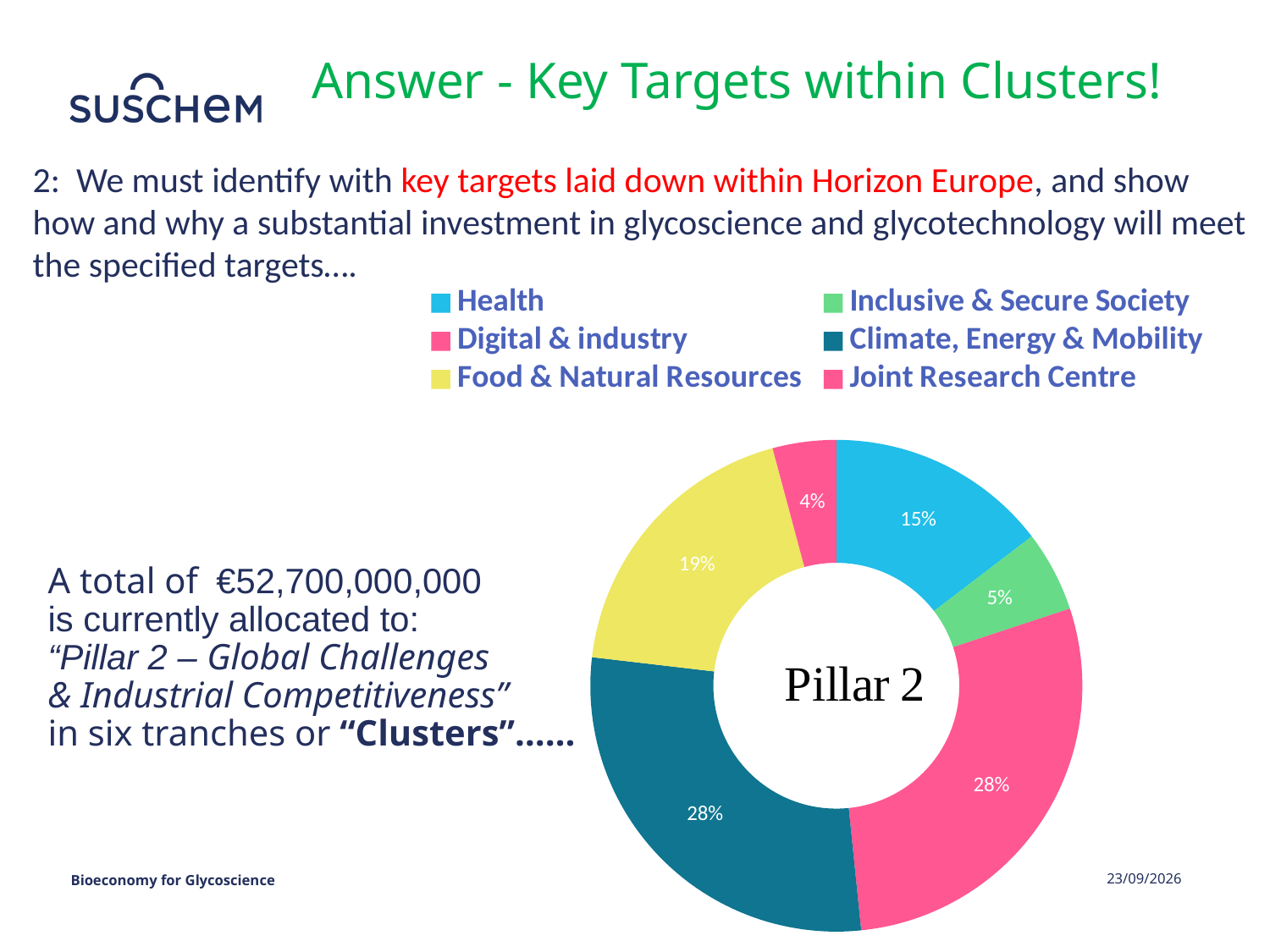
How many clusters (slices) are shown in the Pillar 2 chart? 6 What percentage share does Food & Natural Resources have in the Pillar 2 chart? 19% How many entries does the legend of the Pillar 2 chart list? 6 What is the difference in percentage points between Food & Natural Resources and Health in the Pillar 2 chart? 4 percentage points Which has the larger share in the Pillar 2 chart, Health or Food & Natural Resources? Food & Natural Resources What percentage share does Health have in the Pillar 2 chart? 15% What percentage share does Climate, Energy & Mobility have in the Pillar 2 chart? 28% What percentage share does Inclusive & Secure Society have in the Pillar 2 chart? 5% Which cluster has the smallest share in the Pillar 2 chart? Joint Research Centre What percentage share does Joint Research Centre have in the Pillar 2 chart? 4% What text is shown in the centre of the doughnut chart? Pillar 2 What kind of chart is shown on the slide? Doughnut (pie) chart